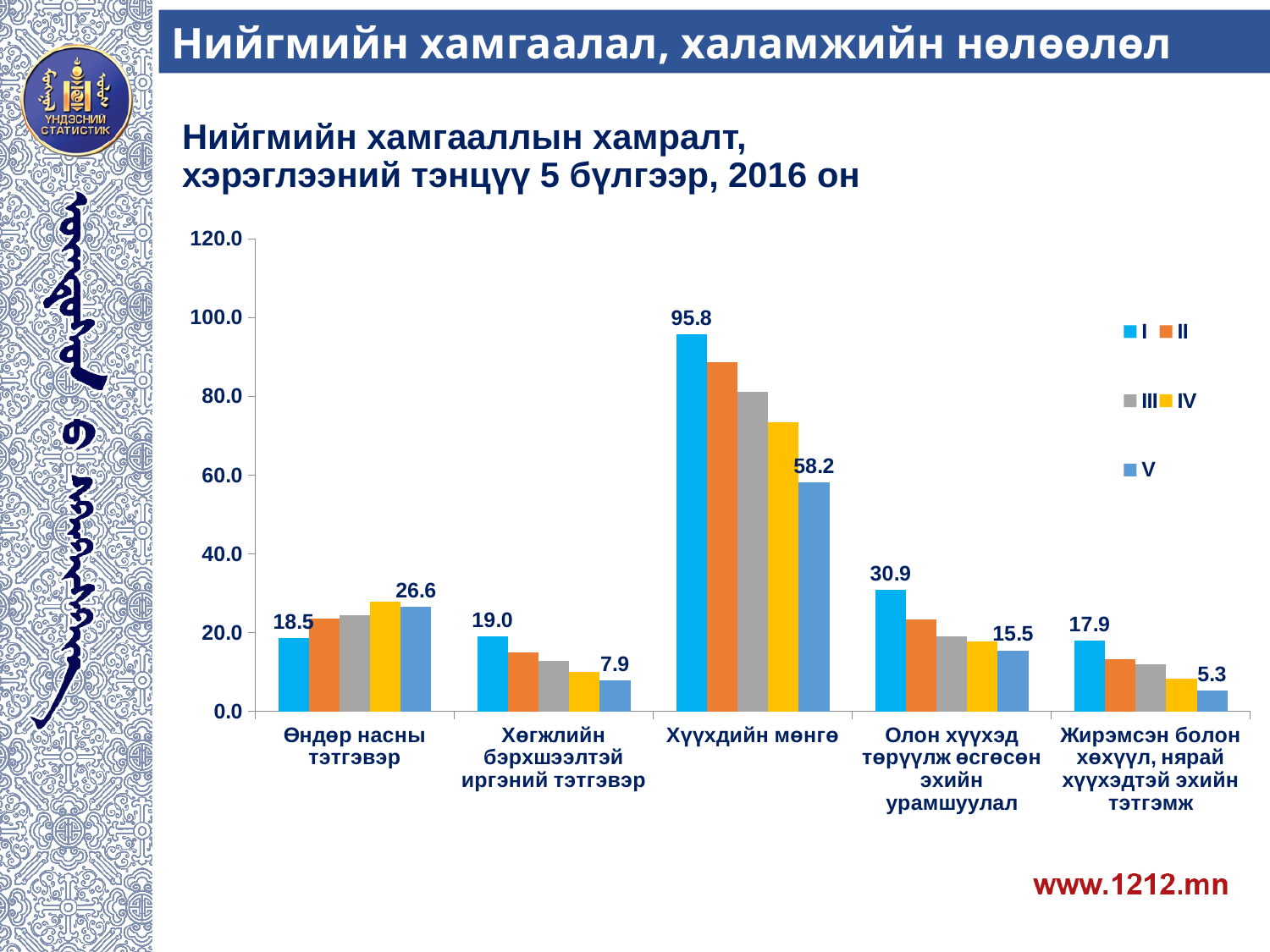
Which category has the highest value for series I? Хүүхдийн мөнгө For Өндөр насны тэтгэвэр, which is larger: series I or series V? series V What is the difference between series I and series V for Хүүхдийн мөнгө? 37.6 What is the value of series V for Өндөр насны тэтгэвэр? 26.6 What is the value of series I for Хүүхдийн мөнгө? 95.8 How many categories are shown on the x axis? 5 What is the title of the chart? Нийгмийн хамгааллын хамралт, хэрэглээний тэнцүү 5 бүлгээр, 2016 он Which category has the lowest value for series V? Жирэмсэн болон хөхүүл, нярай хүүхэдтэй эхийн тэтгэмж What type of chart is shown on the slide? bar chart How many series does the legend list? 5 What is the value of series V for Жирэмсэн болон хөхүүл, нярай хүүхэдтэй эхийн тэтгэмж? 5.3 Is the value of series II for Хүүхдийн мөнгө greater or less than 80.0? greater